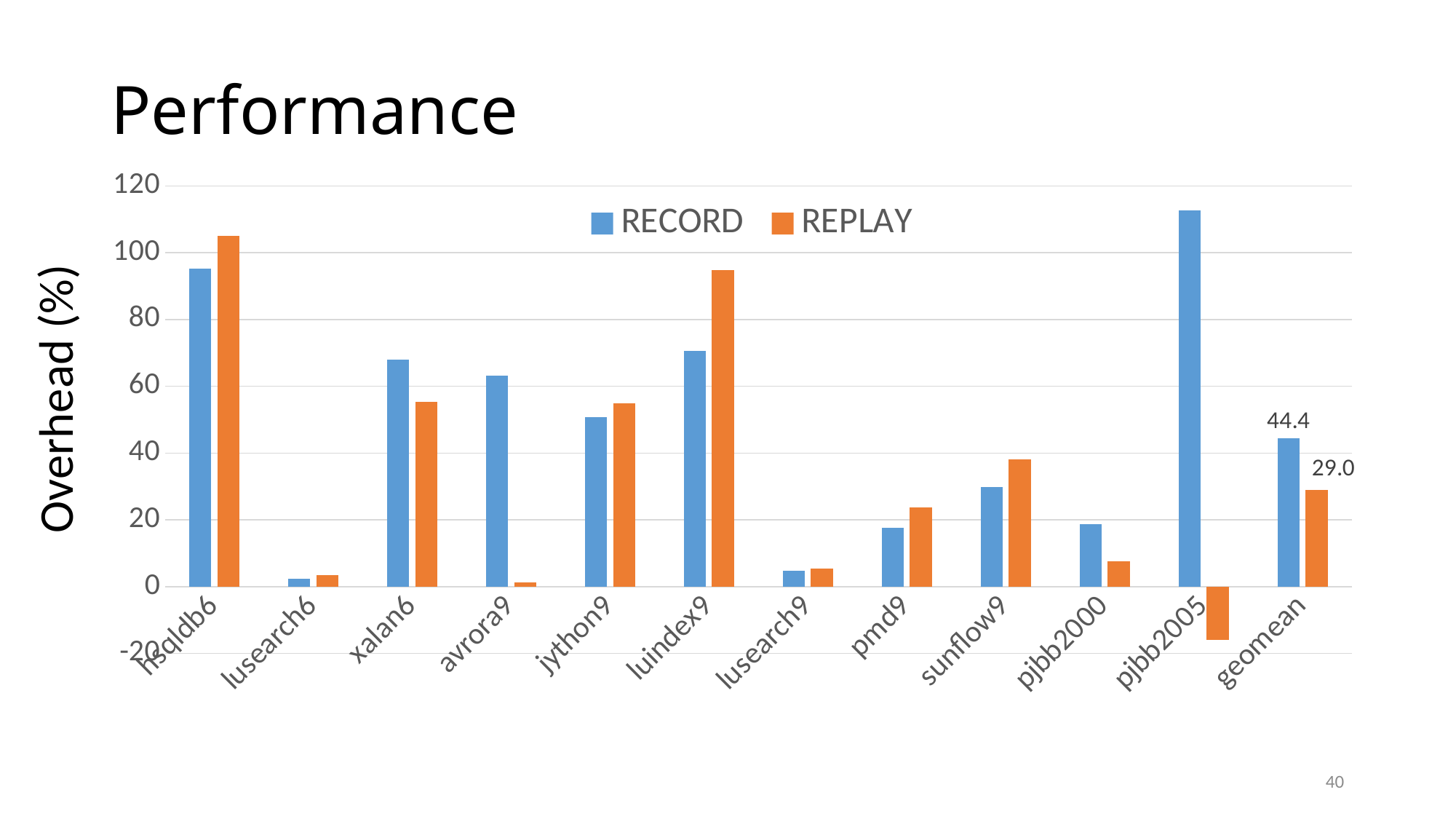
What is the difference between the RECORD and REPLAY values for geomean? 15.4 Is the RECORD value for pjbb2005 greater or less than 100? greater Which category has the lowest REPLAY value? pjbb2005 Is the REPLAY value for xalan6 greater or less than 60? less What is the REPLAY value for geomean? 29.0 Which category has the highest RECORD value? pjbb2005 For avrora9, which series has the larger value, RECORD or REPLAY? RECORD For luindex9, which series has the larger value, RECORD or REPLAY? REPLAY How many series does the legend list? 2 What is the RECORD value for geomean? 44.4 How many categories are shown on the x axis? 12 Which category has the highest REPLAY value? hsqldb6